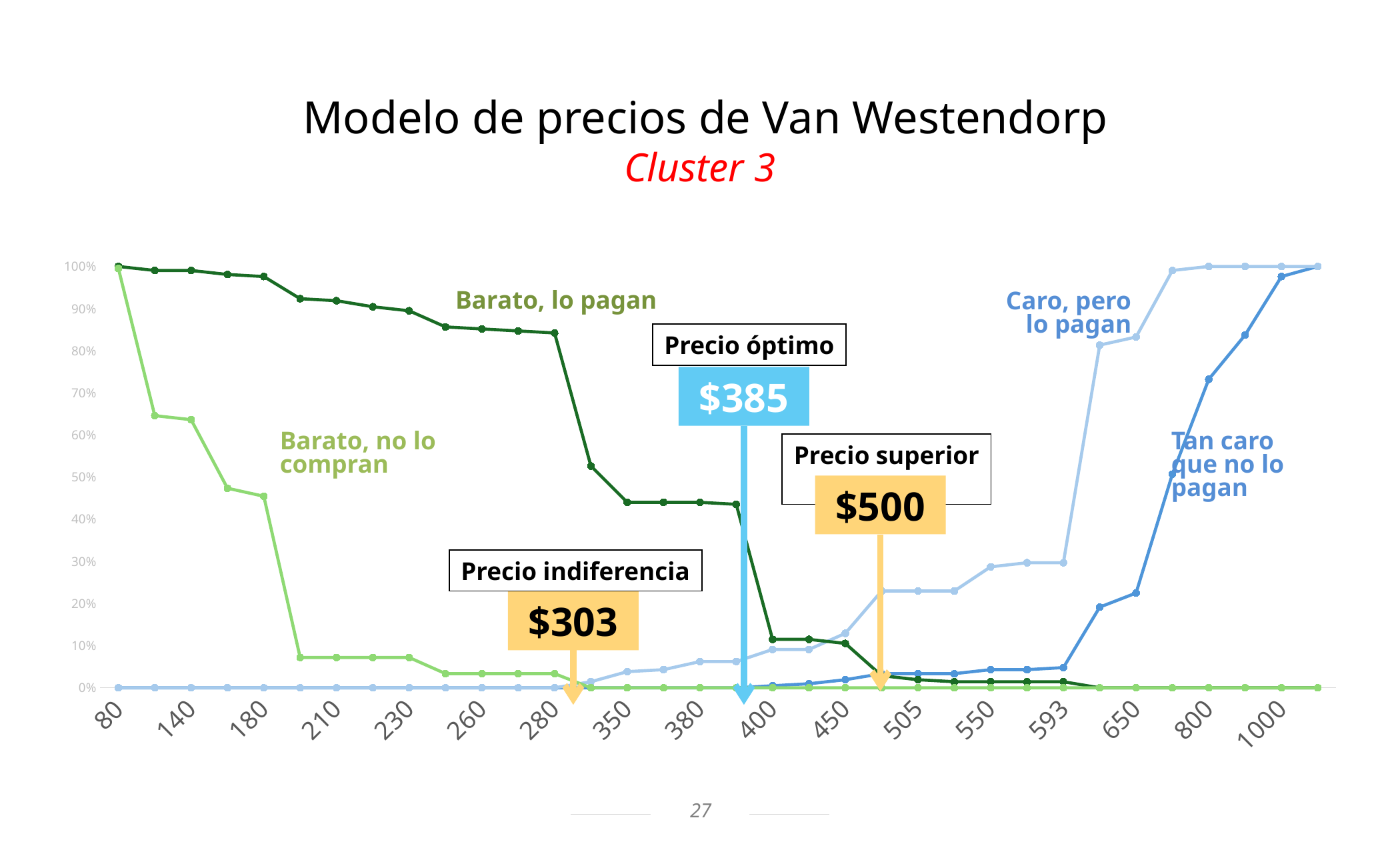
Does the 'Barato, lo pagan' series rise or fall as price increases along the x axis? fall What is the value of the 'Tan caro que no lo pagan' series at a price of 80? 0% Does the 'Tan caro que no lo pagan' series rise or fall as price increases along the x axis? rise Is the value of 'Caro, pero lo pagan' at a price of 550 greater or less than 20%? greater What price is labelled as the 'Precio óptimo' on the chart? $385 Is the value of 'Barato, no lo compran' at a price of 210 greater or less than 10%? less What is the value of the 'Barato, lo pagan' series at a price of 80? 100% How many series are plotted on the chart? 4 What kind of chart is shown on the slide? line chart Is the value of 'Barato, lo pagan' at a price of 350 greater or less than 50%? less How many price labels are shown on the x axis? 17